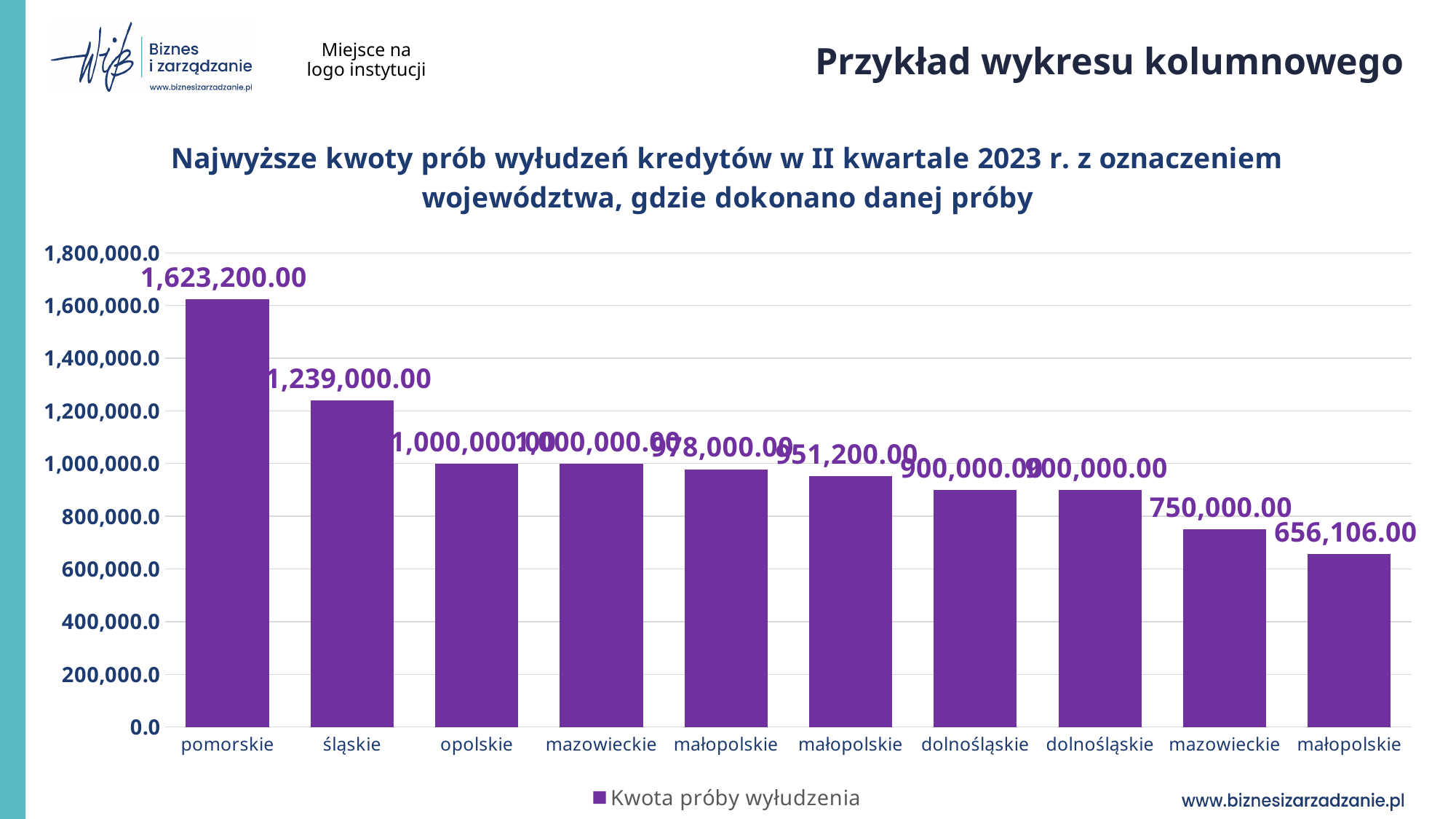
What is the difference between the values for pomorskie and śląskie? 384,200.00 Which category has the lowest value? małopolskie How many series does the legend list? 1 What kind of chart is shown on the slide? bar chart What is the value of the mazowieckie bar that is second from the right? 750,000.00 Which category has the highest value? pomorskie What is the value of the rightmost bar (małopolskie)? 656,106.00 How many bars are shown in the chart? 10 Is the value for opolskie greater or less than 1,200,000.0? less Which is larger, the value for pomorskie or the value for śląskie? pomorskie What is the value for pomorskie? 1,623,200.00 What is the value for śląskie? 1,239,000.00